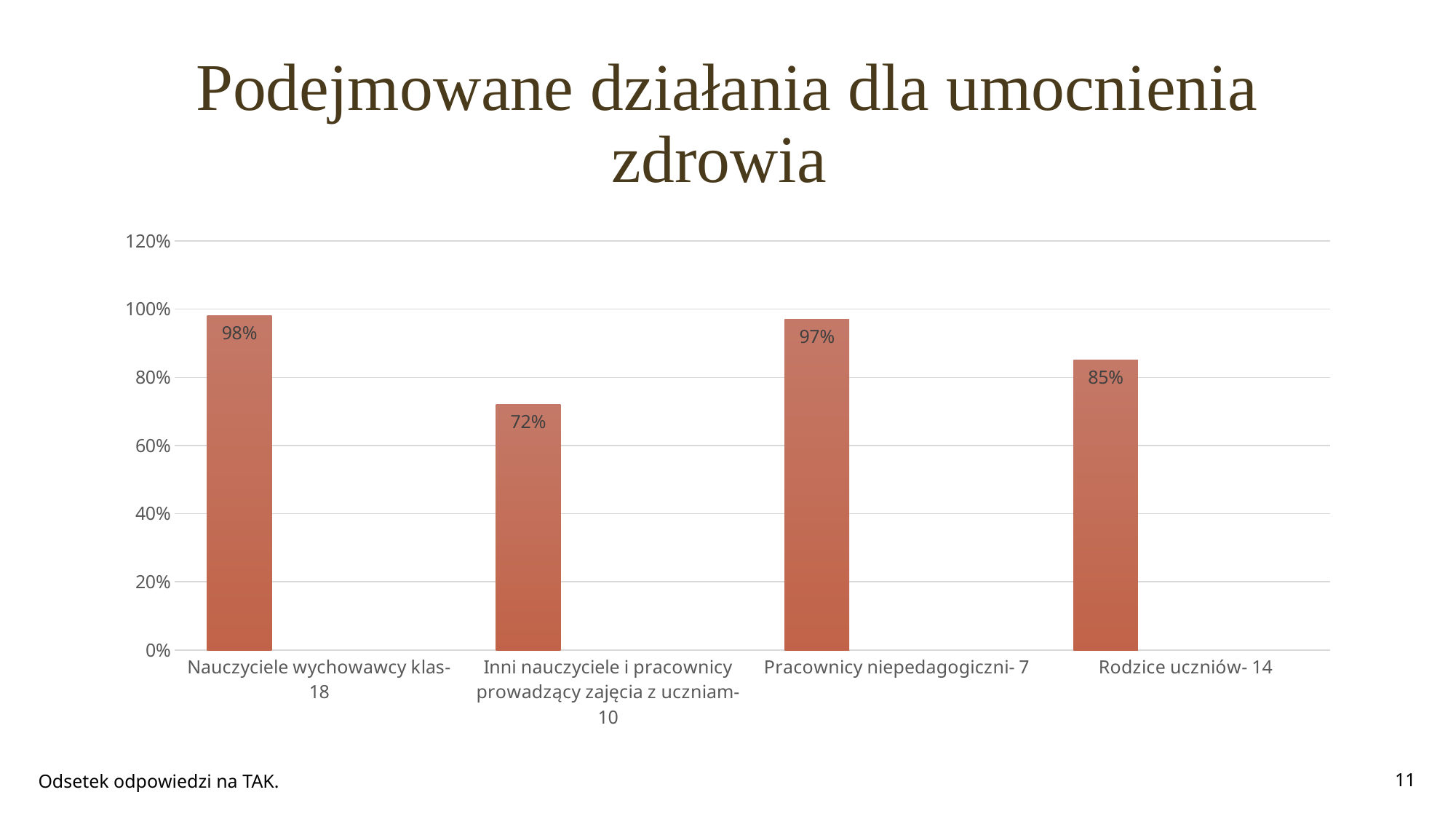
What is the value for Rodzice uczniów- 14? 85% What is the title of the chart on the slide? Podejmowane działania dla umocnienia zdrowia What is the value for Pracownicy niepedagogiczni- 7? 97% How many categories are shown in the chart? 4 What is the difference between the values for Pracownicy niepedagogiczni- 7 and Rodzice uczniów- 14? 12% Which category has the lowest value? Inni nauczyciele i pracownicy prowadzący zajęcia z uczniam- 10 What is the value for Inni nauczyciele i pracownicy prowadzący zajęcia z uczniam- 10? 72% What is the difference between the values for Nauczyciele wychowawcy klas- 18 and Inni nauczyciele i pracownicy prowadzący zajęcia z uczniam- 10? 26% What kind of chart is shown on the slide? bar chart What is the value for Nauczyciele wychowawcy klas- 18? 98% Which is larger, the value for Rodzice uczniów- 14 or the value for Inni nauczyciele i pracownicy prowadzący zajęcia z uczniam- 10? Rodzice uczniów- 14 Is the value for Rodzice uczniów- 14 greater or less than 80%? greater